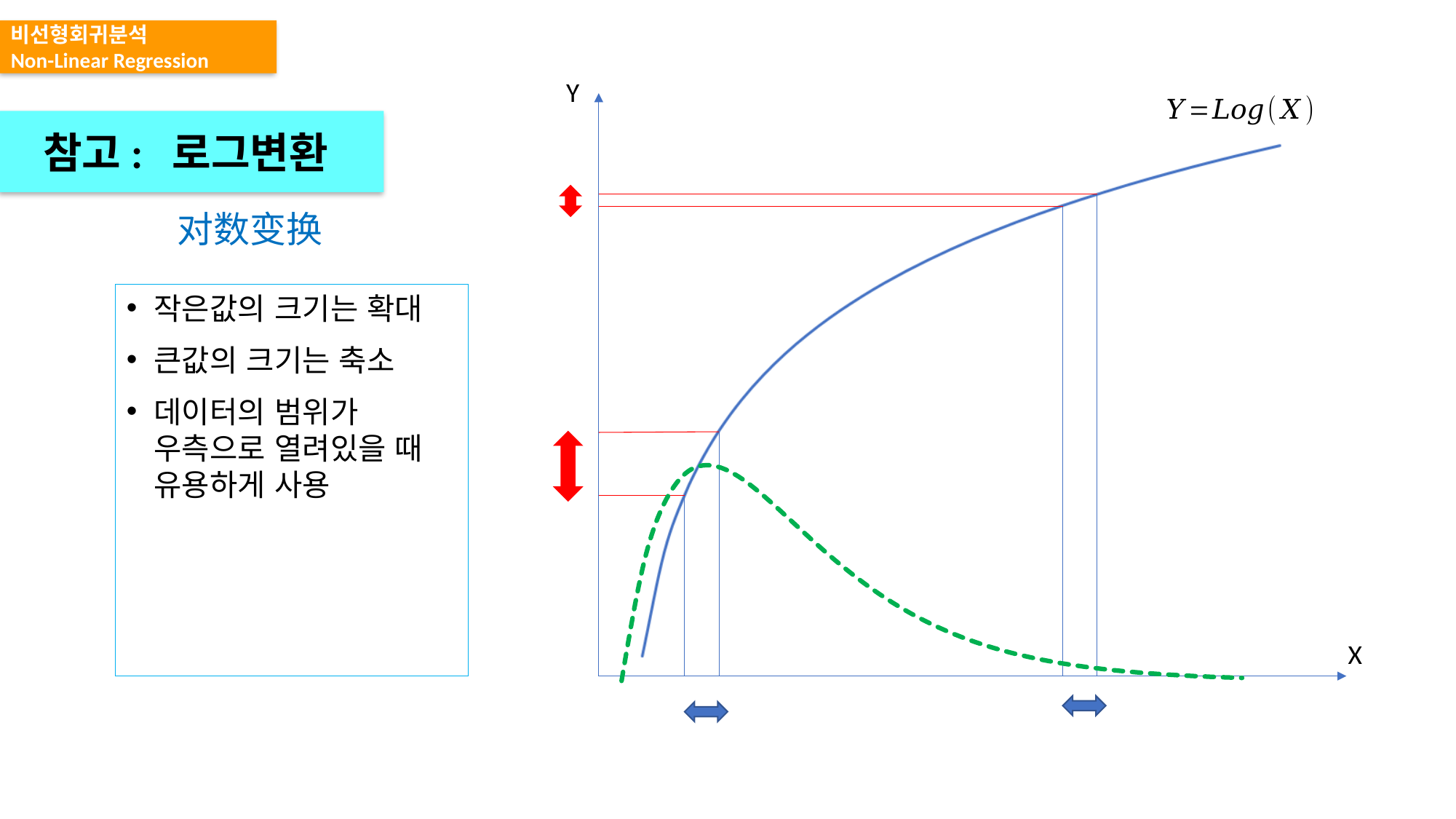
Does the solid blue curve Y = Log(X) rise or fall as X increases? rise What equation is written above the solid blue curve? Y = Log(X) What label is shown on the vertical axis? Y Is the dashed green curve rising or falling on the right-hand side of the chart? falling What label is shown on the horizontal axis? X How many curves are plotted on the chart? 2 What kind of chart is shown on the slide? line chart Which red vertical arrow is longer, the one near the bottom of the Y axis or the one near the top? the one near the bottom